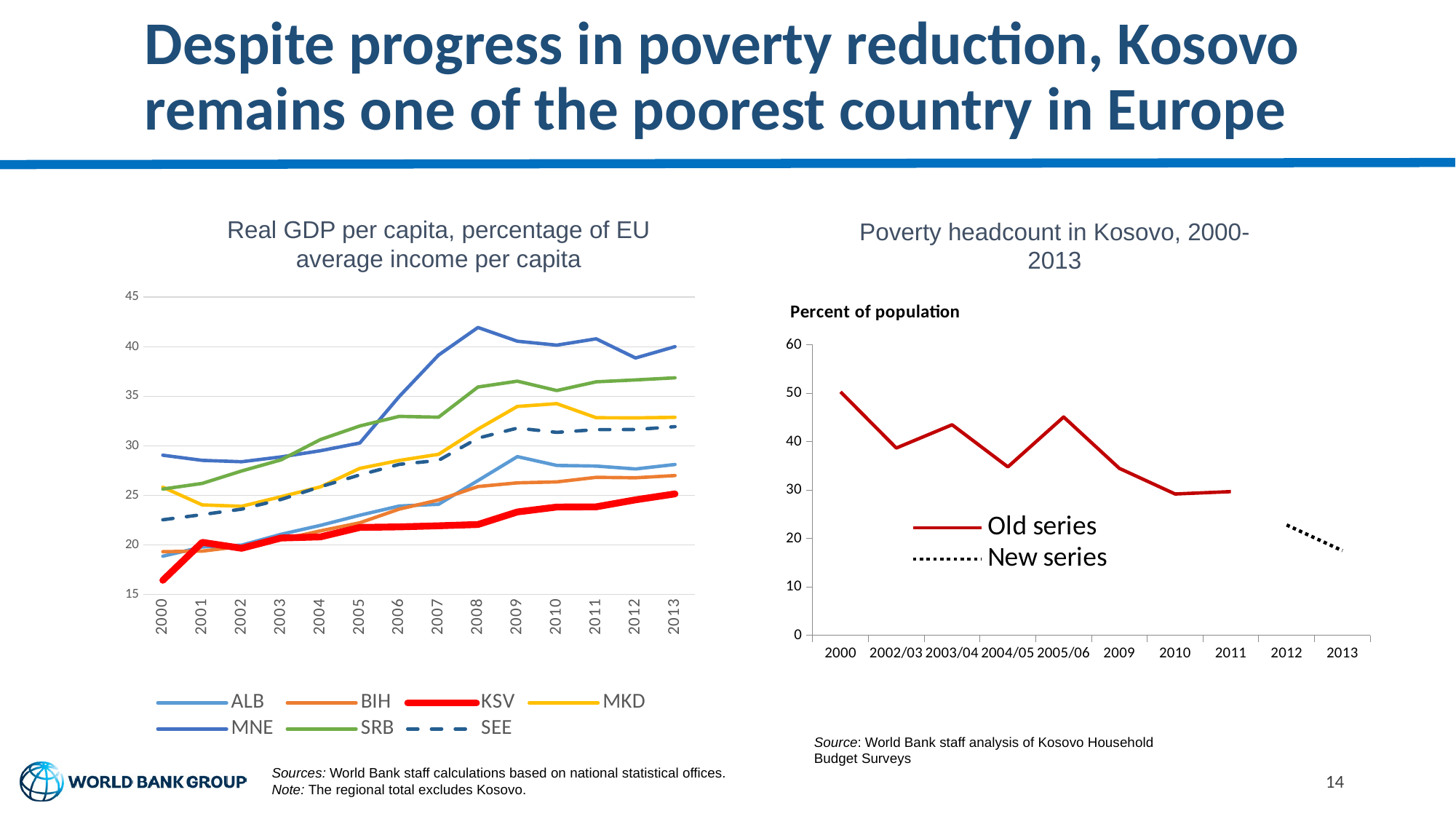
In the 'Real GDP per capita' chart, which series has the highest value in 2008? MNE In the 'Poverty headcount in Kosovo, 2000-2013' chart, is the New series value for 2013 greater or less than 20? less In the 'Real GDP per capita' chart, is the value for KSV in 2000 greater or less than 20? less In the 'Poverty headcount in Kosovo, 2000-2013' chart, which year has the highest value of the Old series? 2000 What kind of chart is the 'Real GDP per capita, percentage of EU average income per capita' chart? line chart In the 'Real GDP per capita' chart, does the KSV series rise or fall from 2000 to 2013? rise How many series does the legend of the 'Real GDP per capita' chart list? 7 In the 'Real GDP per capita' chart, is the value for MNE in 2008 greater or less than 40? greater In the 'Real GDP per capita' chart, which series has the lowest value in 2000? KSV How many series does the legend of the 'Poverty headcount in Kosovo, 2000-2013' chart list? 2 How many years are shown on the x axis of the 'Real GDP per capita' chart? 14